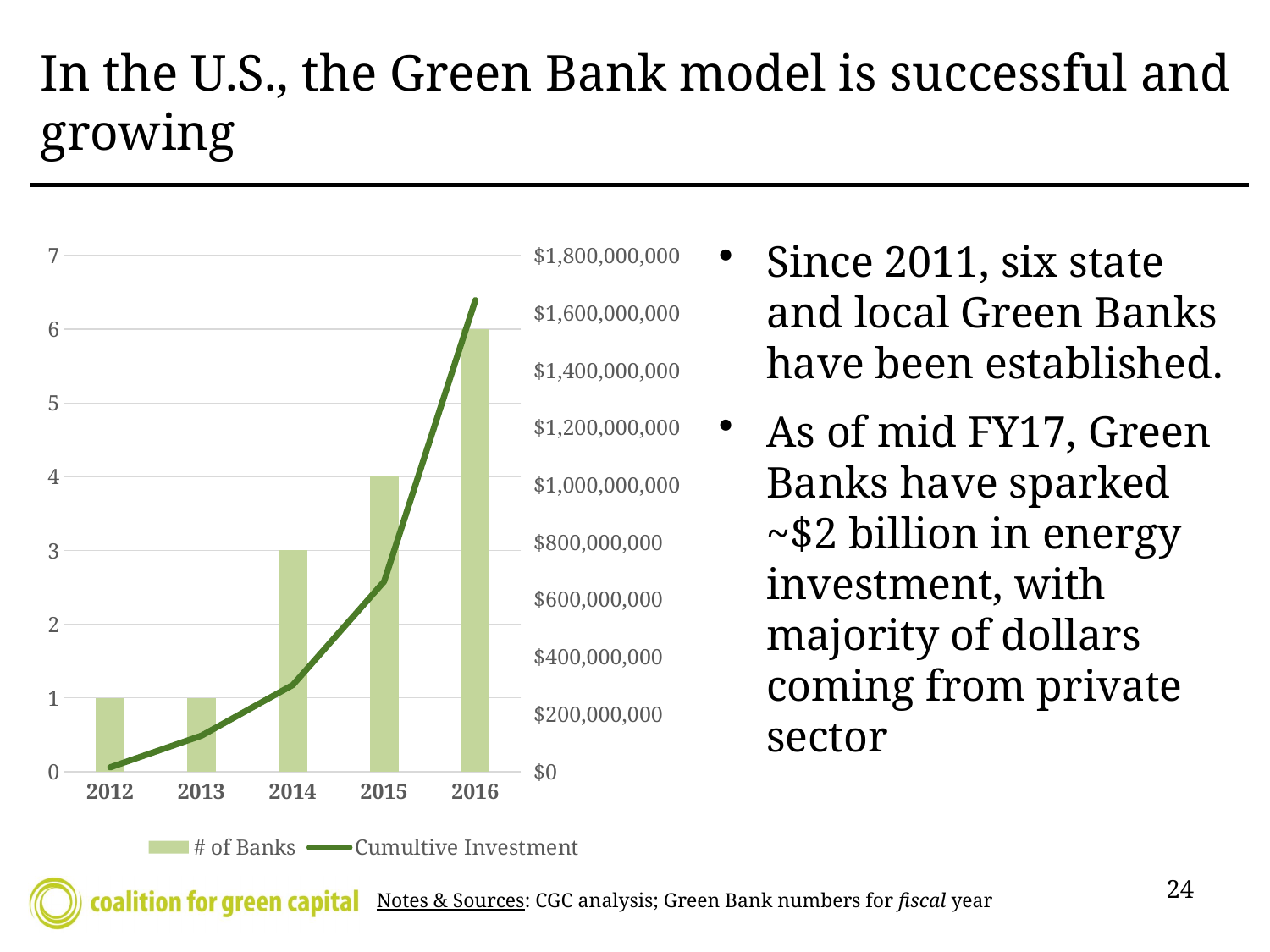
What is the # of Banks value for 2015? 4 What is the # of Banks value for 2014? 3 Which series is drawn as a line in the chart? Cumultive Investment Which year has the highest # of Banks? 2016 How many years are shown on the x axis of the chart? 5 Does the Cumultive Investment line rise or fall from 2012 to 2016? rise Is the Cumultive Investment value for 2014 greater or less than $600,000,000? less How many series does the legend list? 2 Is the Cumultive Investment value for 2016 greater or less than $1,400,000,000? greater Which year has a larger # of Banks, 2013 or 2015? 2015 What is the difference in # of Banks between 2016 and 2014? 3 What is the # of Banks value for 2016? 6